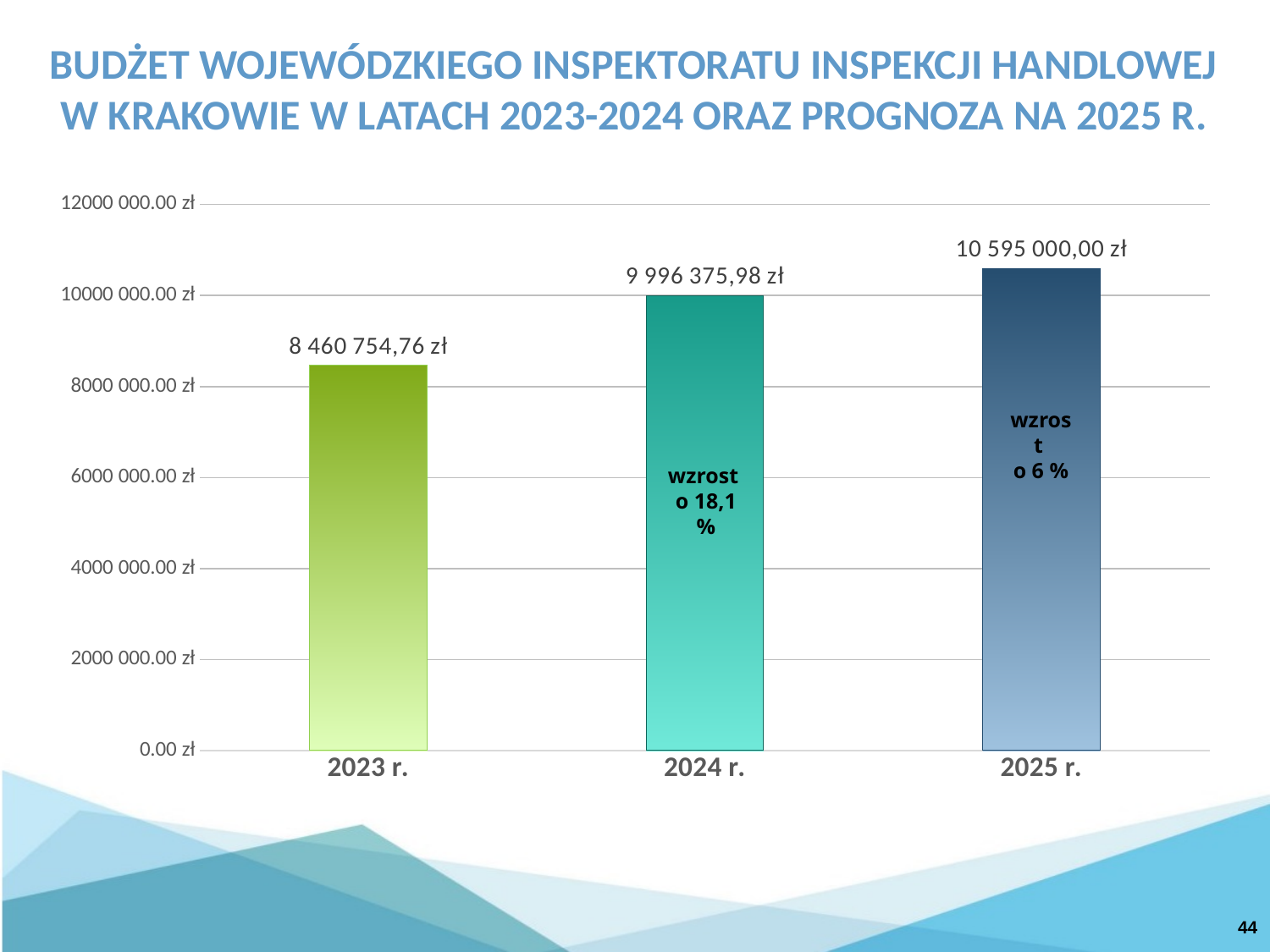
What is the forecast budget value shown for 2025 r.? 10 595 000,00 zł Is the value for 2025 r. greater or less than 10000 000.00 zł? greater Which year has the lowest budget value? 2023 r. What is the difference between the 2024 r. and 2023 r. budget values? 1 535 621,22 zł How many years (bars) are shown in the chart? 3 What percentage increase is labelled on the 2024 r. bar? wzrost o 18,1 % What is the difference between the 2025 r. and 2024 r. budget values? 598 624,02 zł Which year has the highest budget value? 2025 r. What kind of chart is shown on the slide? bar chart What is the budget value shown for 2023 r.? 8 460 754,76 zł Which is larger, the budget for 2023 r. or for 2024 r.? 2024 r. What is the budget value shown for 2024 r.? 9 996 375,98 zł